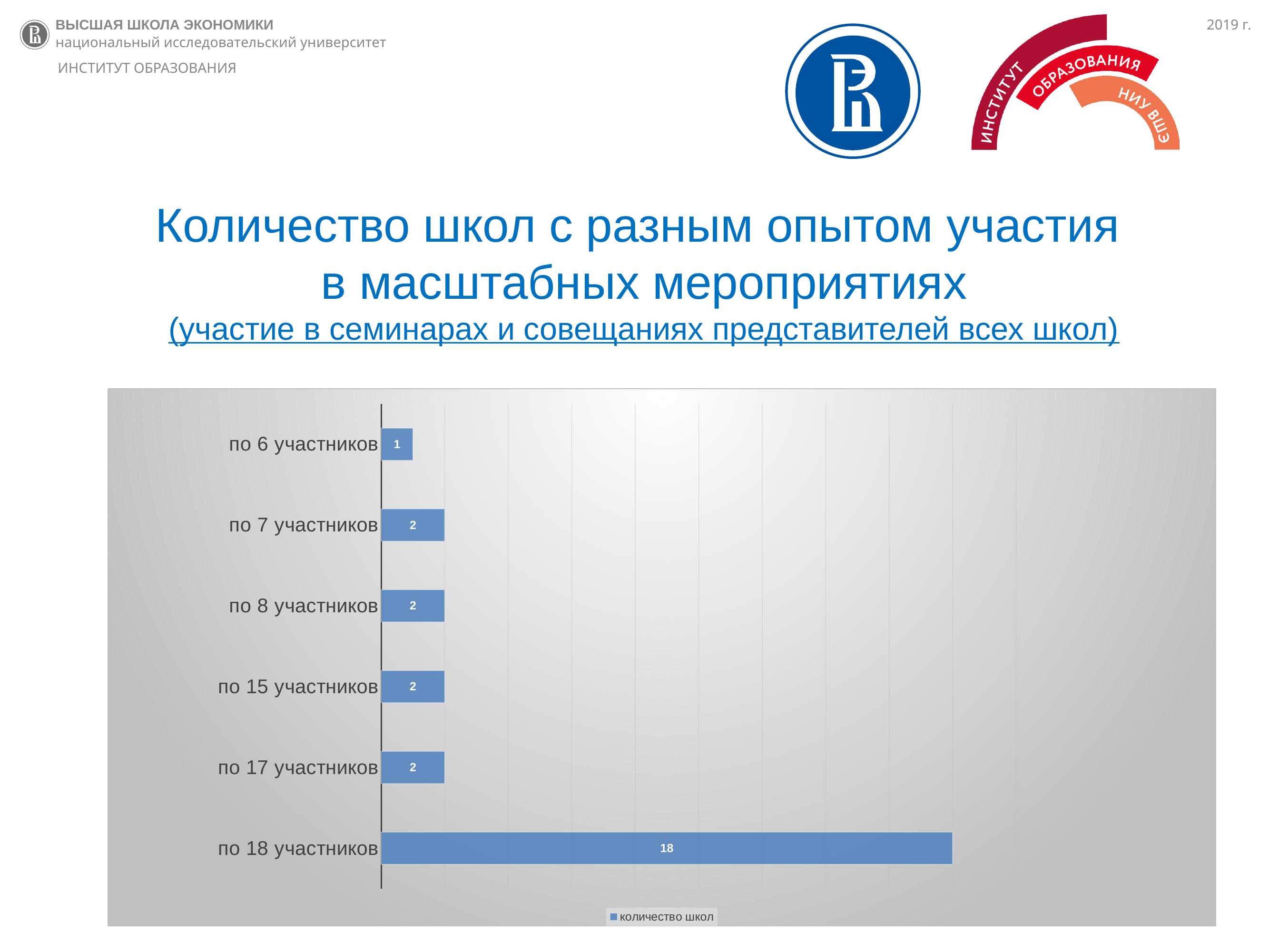
What kind of chart is shown on the slide? bar chart How many series does the legend list? 1 Which is larger, the value for "по 17 участников" or the value for "по 6 участников"? по 17 участников What is the difference between the values for "по 8 участников" and "по 6 участников"? 1 Which category has the highest value? по 18 участников What is the difference between the values for "по 18 участников" and "по 7 участников"? 16 What is the name of the series shown in the legend? количество школ How many categories are shown in the chart? 6 Which category has the lowest value? по 6 участников What is the value for "по 6 участников"? 1 What is the value for "по 18 участников"? 18 What is the value for "по 15 участников"? 2